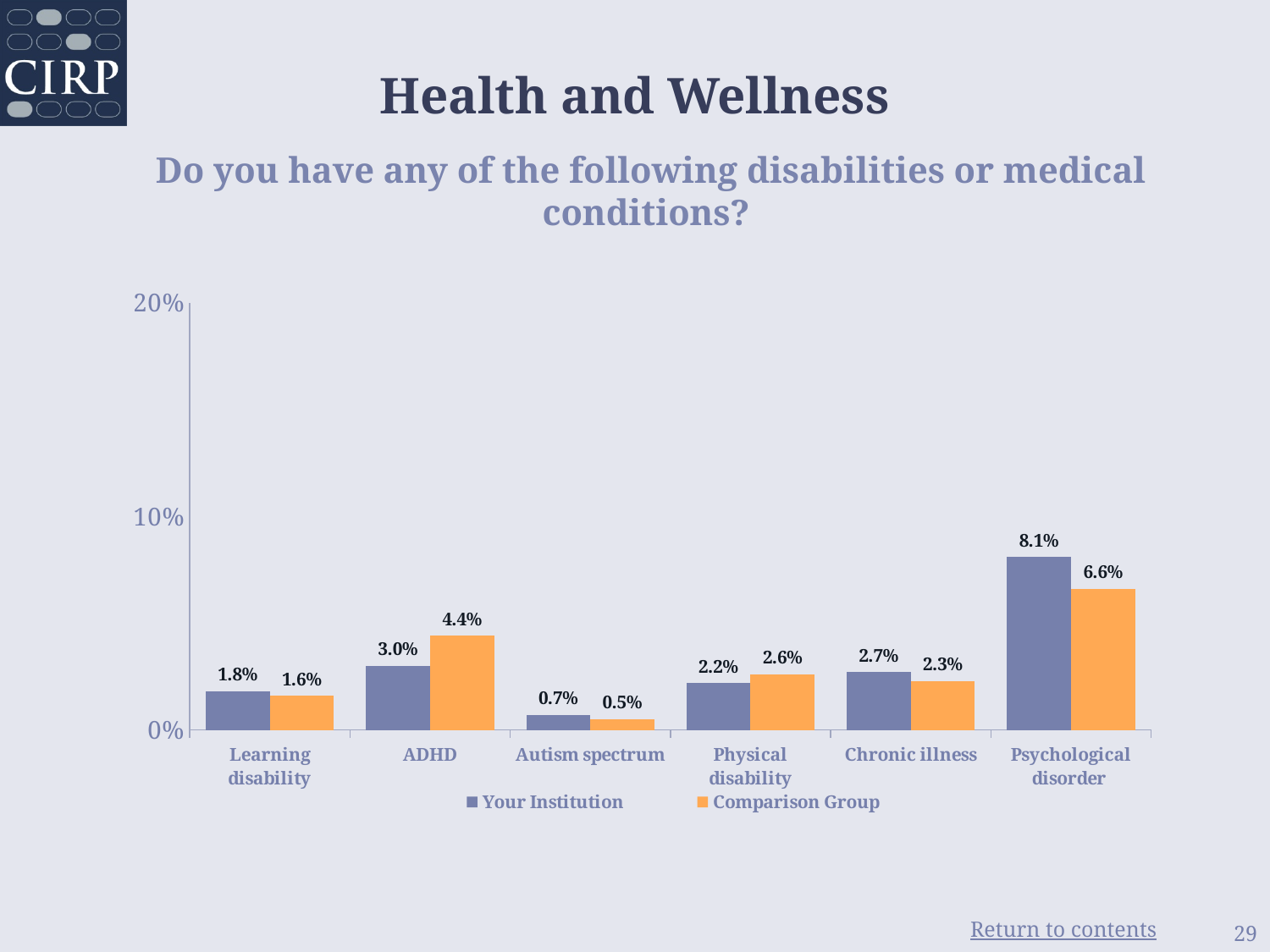
Which category has the lowest value for Comparison Group? Autism spectrum How many categories are shown on the x axis? 6 Which category has the highest value for Your Institution? Psychological disorder How many series does the legend list? 2 What is the value for Comparison Group for ADHD? 4.4% What is the difference between Your Institution and Comparison Group for Psychological disorder? 1.5% What is the value for Your Institution for Autism spectrum? 0.7% What is the value for Comparison Group for Chronic illness? 2.3% What is the value for Your Institution for Psychological disorder? 8.1% Is the value for Your Institution for Psychological disorder greater or less than 10%? less What kind of chart is shown on the slide? bar chart For ADHD, which is larger: Your Institution or Comparison Group? Comparison Group